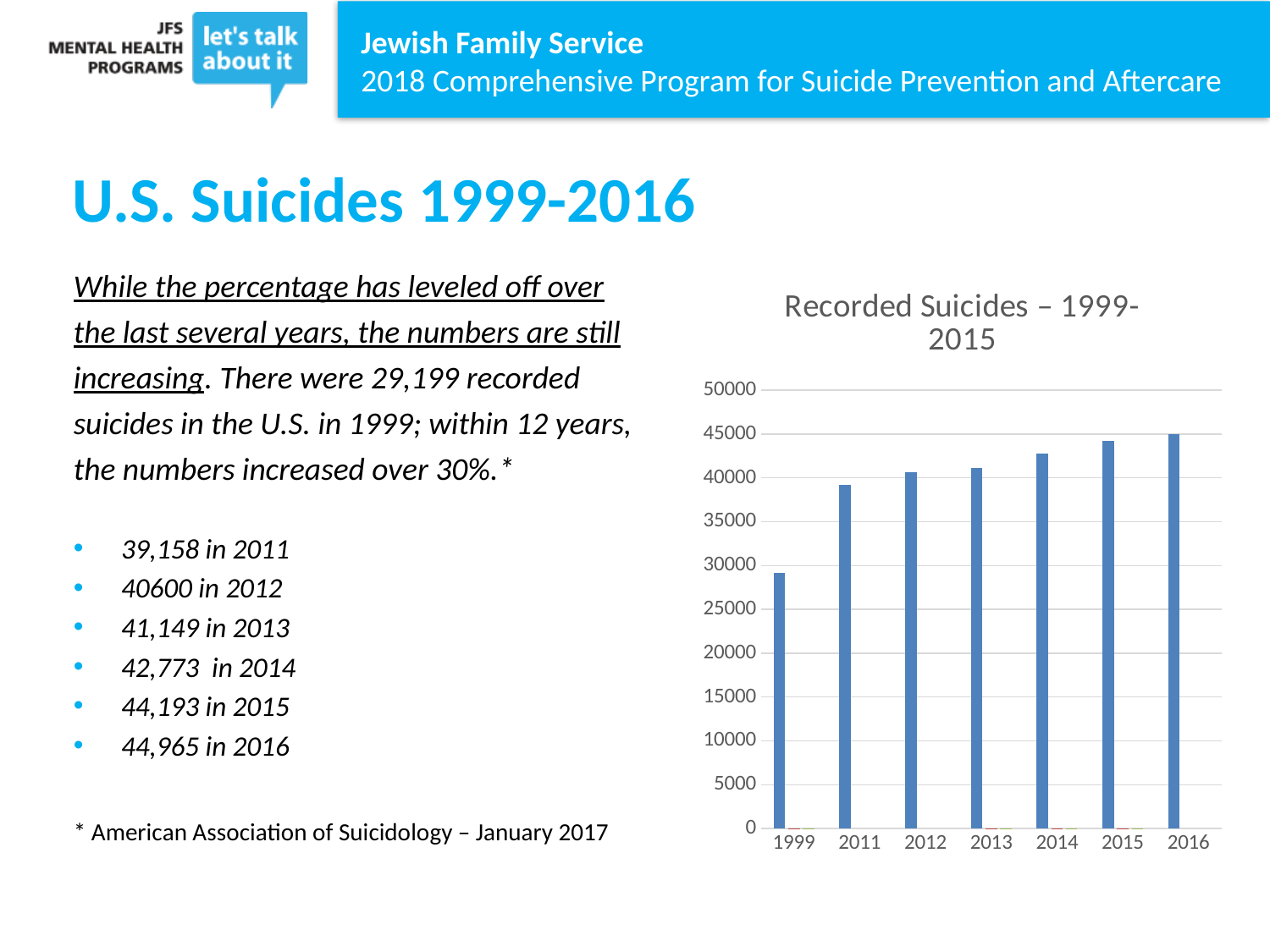
How many years are plotted on the chart? 7 Which is larger, the value for 1999 or the value for 2011? 2011 Which year has the lowest bar on the chart? 1999 Is the value for 2012 greater or less than 35000? greater Is the value for 1999 greater or less than 30000? less What is the title of the chart? Recorded Suicides – 1999-2015 Do the values rise or fall from 1999 to 2016 along the x axis? rise Which is larger, the value for 2014 or the value for 2012? 2014 Is the value for 2011 greater or less than 40000? less What kind of chart is shown on the slide? bar chart